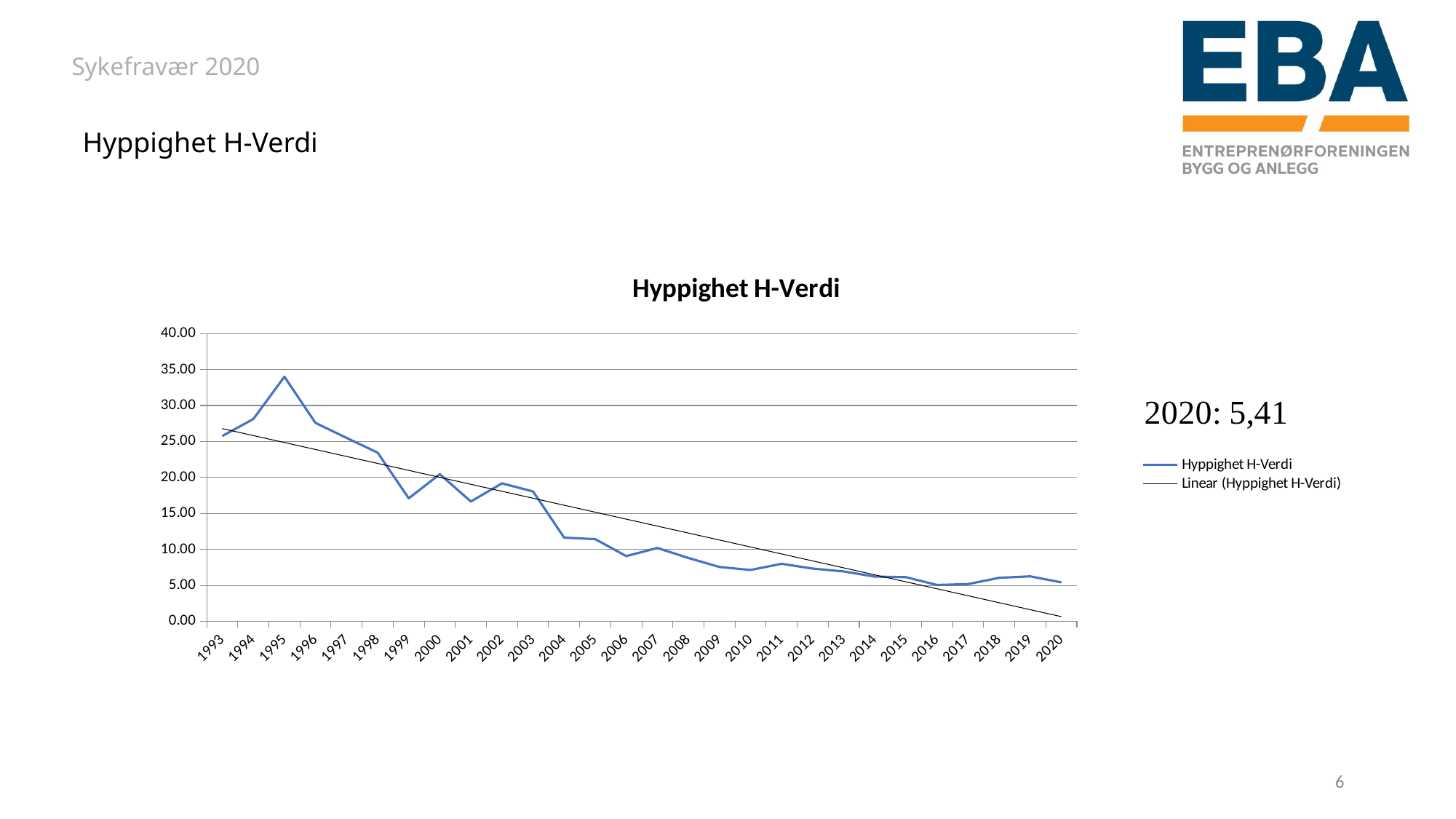
How many years are plotted along the x axis of the chart? 28 Which year has the highest Hyppighet H-Verdi value? 1995 Which year has the larger Hyppighet H-Verdi value, 2004 or 2010? 2004 Which year has the larger Hyppighet H-Verdi value, 2000 or 2001? 2000 How many series does the chart legend list? 2 What is the title of the chart? Hyppighet H-Verdi Is the Hyppighet H-Verdi value for 2010 greater or less than 10.00? less What kind of chart is shown on the slide? line chart Is the Hyppighet H-Verdi value for 1999 greater or less than 20.00? less Do the Hyppighet H-Verdi values generally rise or fall from 1993 to 2020? fall Is the Hyppighet H-Verdi value for 1995 greater or less than 30.00? greater What is the Hyppighet H-Verdi value for 2020, as stated on the slide? 5,41